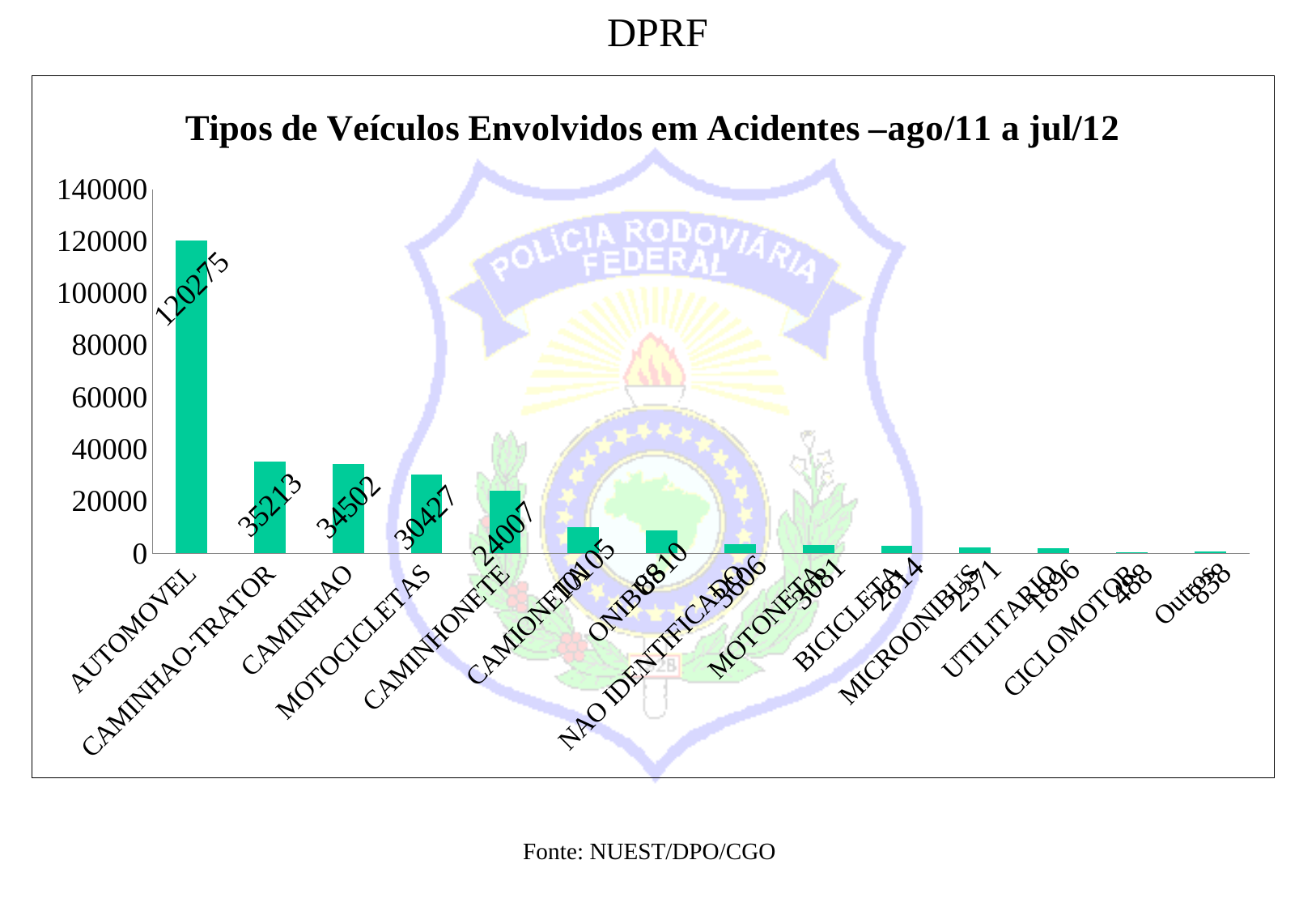
What is the value for MOTOCICLETAS? 30427 What is the difference between the values for MOTOCICLETAS and CAMINHONETE? 6420 Which is larger, the value for CAMINHAO-TRATOR or the value for CAMINHAO? CAMINHAO-TRATOR How many vehicle categories are shown on the x axis? 14 What type of chart is shown on the slide? bar chart Do the values rise or fall from left to right along the x axis? fall Is the value for ONIBUS greater or less than 20000? less What is the difference between the values for AUTOMOVEL and CAMINHAO-TRATOR? 85062 Which vehicle type has the highest value? AUTOMOVEL What is the value for CAMINHAO-TRATOR? 35213 What is the value for AUTOMOVEL? 120275 What is the value for CAMINHONETE? 24007